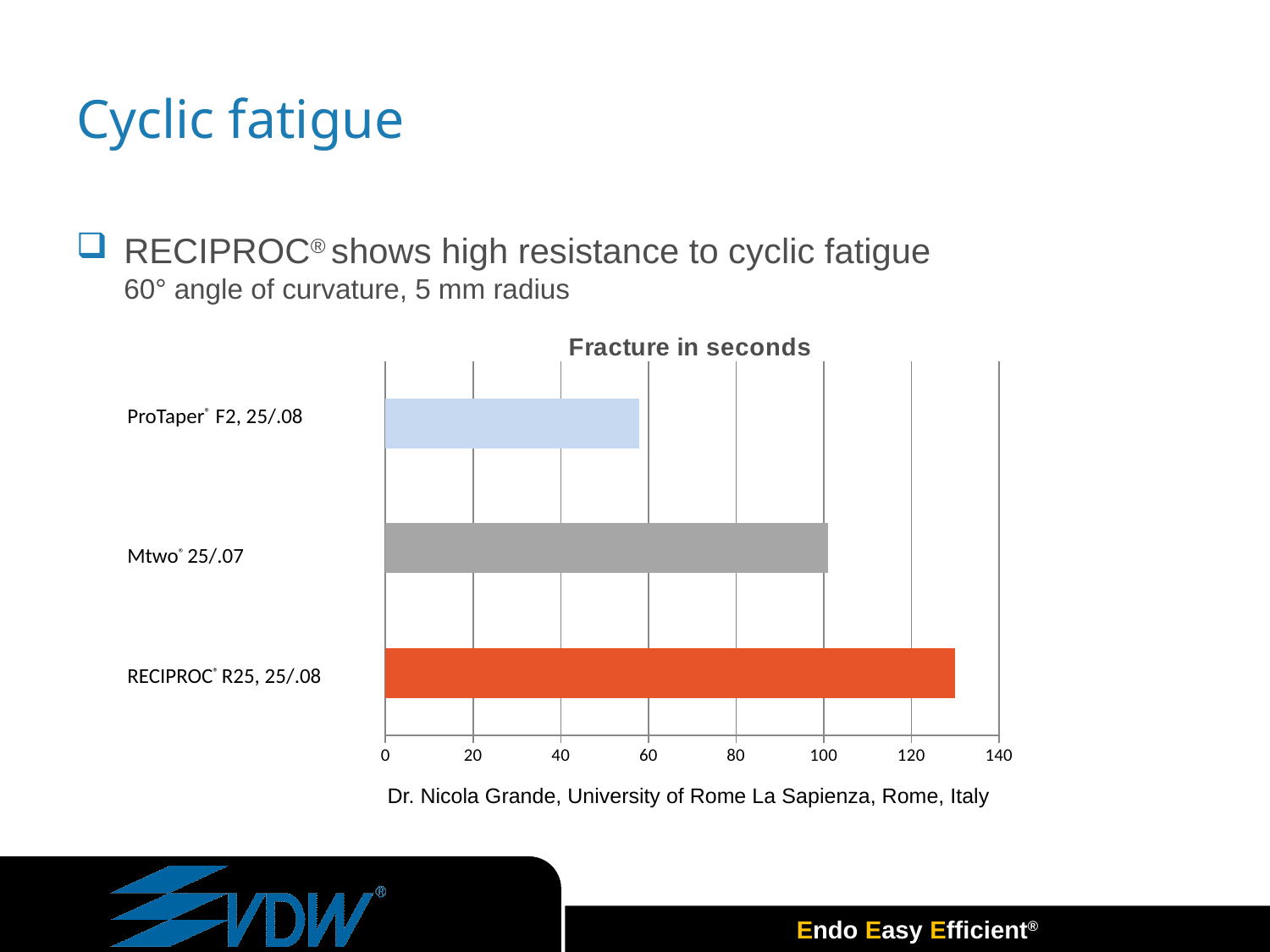
Which has a larger fracture time, RECIPROC R25, 25/.08 or Mtwo 25/.07? RECIPROC R25, 25/.08 What type of chart is shown on the slide? bar chart Is the value for ProTaper F2, 25/.08 greater or less than 40? greater Is the value for Mtwo 25/.07 greater or less than 80? greater Is the value for RECIPROC R25, 25/.08 greater or less than 140? less What colour is the bar for RECIPROC R25, 25/.08? orange-red Which has a larger fracture time, Mtwo 25/.07 or ProTaper F2, 25/.08? Mtwo 25/.07 Which instrument has the highest fracture time in the chart? RECIPROC R25, 25/.08 How many categories (instruments) are plotted in the chart? 3 What is the title of the chart? Fracture in seconds Which instrument has the lowest fracture time in the chart? ProTaper F2, 25/.08